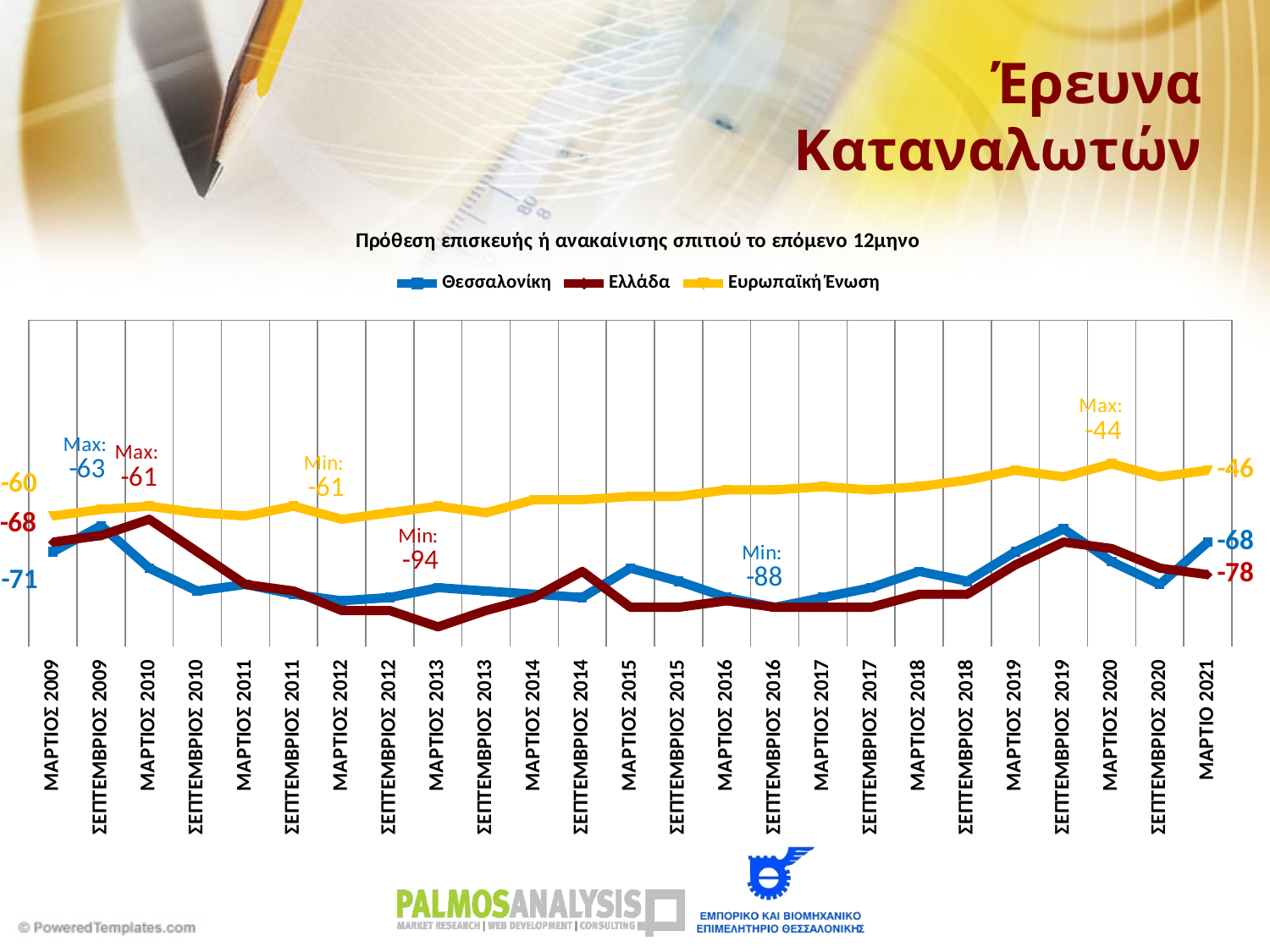
What is the value for Ελλάδα in ΜΑΡΤΙΟ 2021? -78 What is the value for Θεσσαλονίκη in ΜΑΡΤΙΟΣ 2009? -71 How many time points are shown on the x axis? 25 In ΜΑΡΤΙΟΣ 2009, which series has the higher value, Ελλάδα or Θεσσαλονίκη? Ελλάδα What is the minimum value reached by the Θεσσαλονίκη series, as labelled on the chart? -88 What is the maximum value reached by the Ελλάδα series, as labelled on the chart? -61 What is the minimum value reached by the Ελλάδα series, as labelled on the chart? -94 How many series does the legend list? 3 What is the maximum value reached by the Ευρωπαϊκή Ένωση series, as labelled on the chart? -44 What kind of chart is shown on the slide? Line chart In ΜΑΡΤΙΟ 2021, how much higher is the Ευρωπαϊκή Ένωση value than the Ελλάδα value? 32 What is the value for Ευρωπαϊκή Ένωση in ΜΑΡΤΙΟ 2021? -46